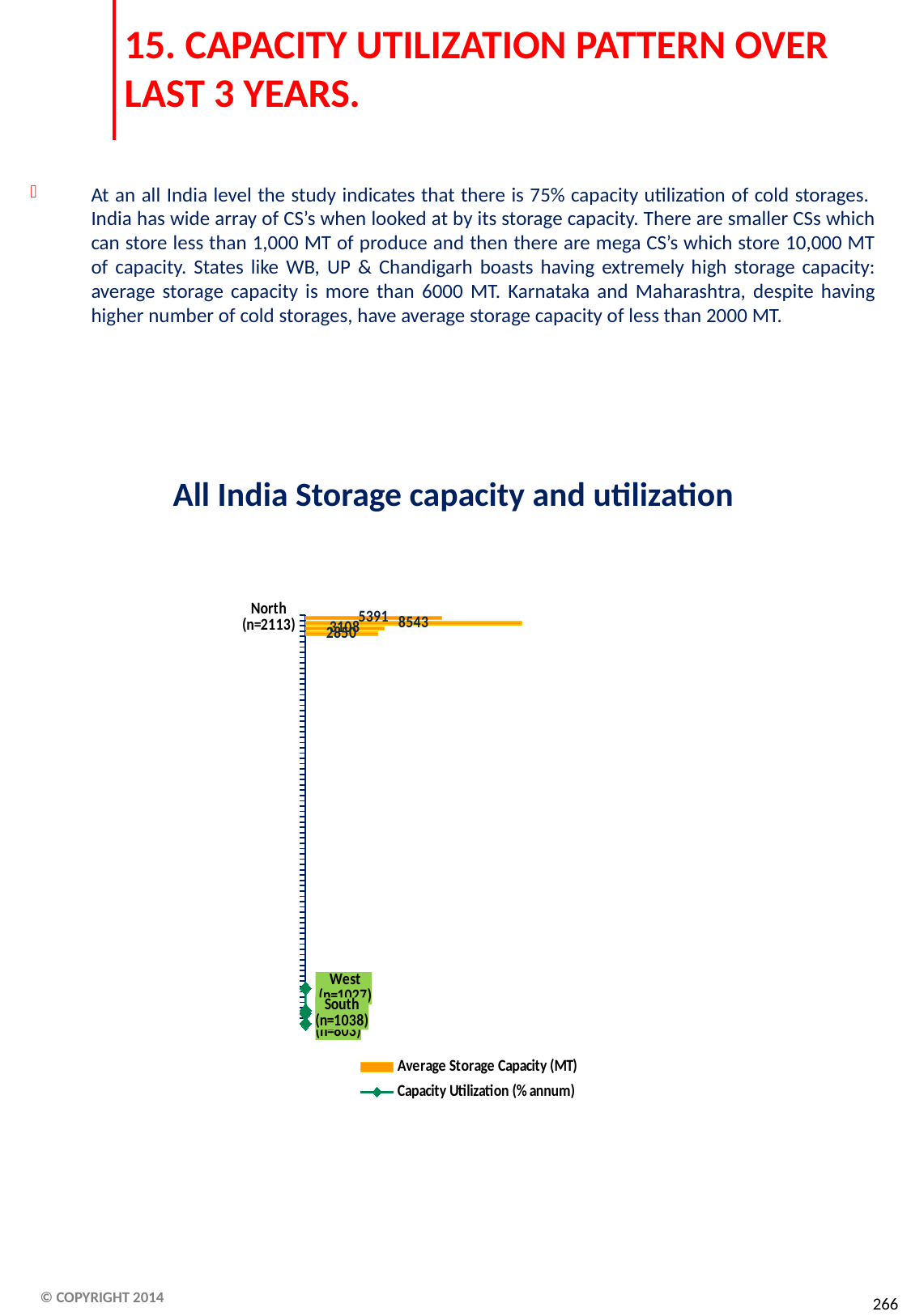
What is the difference between the two largest labelled Average Storage Capacity values, 8543 and 5391? 3152 Which is larger among the labelled Average Storage Capacity values, 8543 or 5391? 8543 What does the orange bar series in the chart represent, according to the legend? Average Storage Capacity (MT) How many series does the chart legend list? 2 What kind of chart is used to show the Average Storage Capacity (MT) series? bar chart What is the highest Average Storage Capacity (MT) value labelled on the chart? 8543 What is the title of the chart on the slide? All India Storage capacity and utilization